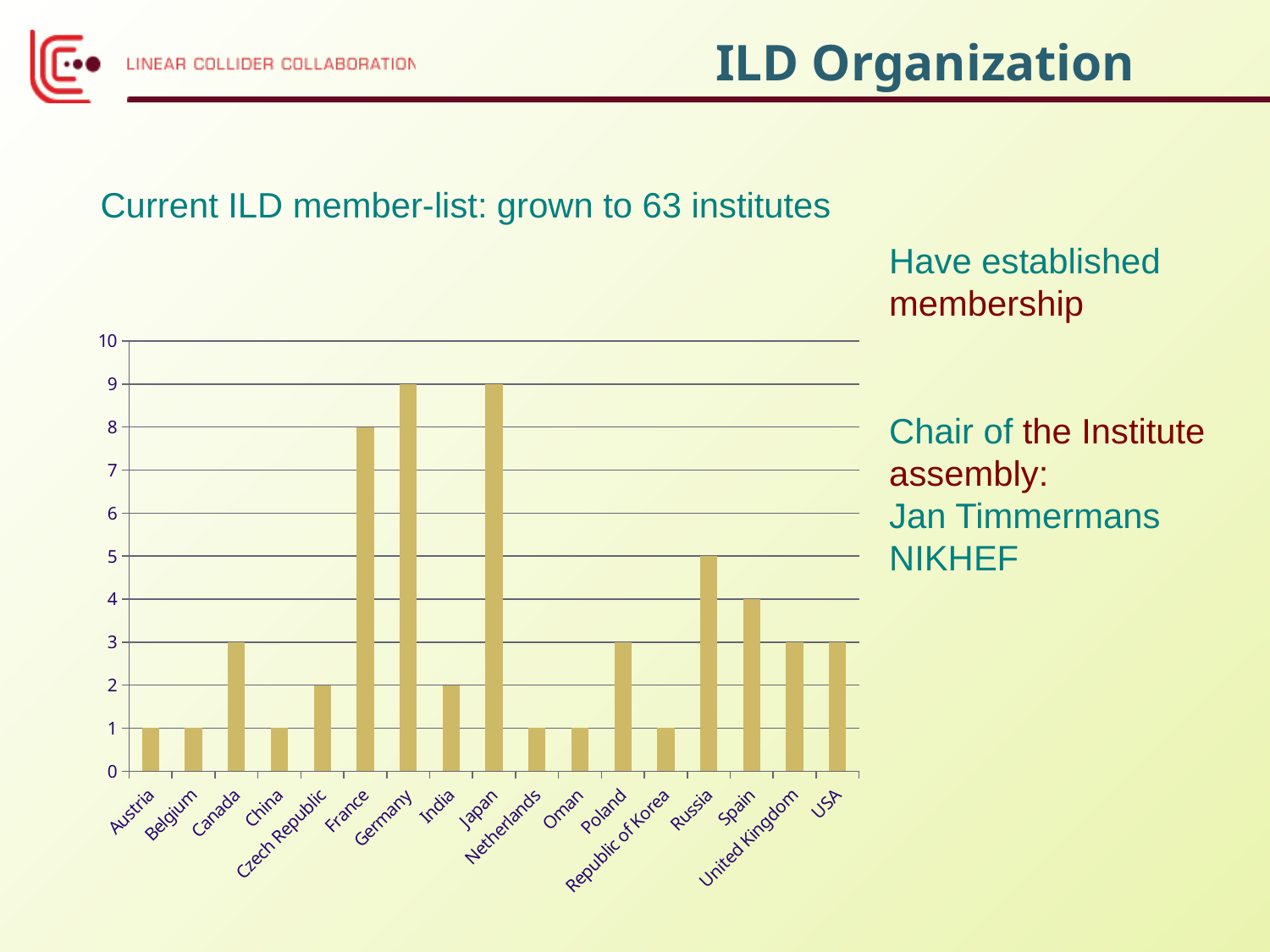
Is the value for Japan greater or less than 5? greater What is the difference between the values for France and Russia? 3 Which is larger, the value for France or the value for Russia? France What is the difference between the values for Germany and France? 1 What is the value for Spain? 4 What kind of chart is shown on the slide? bar chart Which is larger, the value for Spain or the value for Canada? Spain What is the value for Russia? 5 What is the value for Czech Republic? 2 What is the value for Germany? 9 What is the value for France? 8 How many countries are shown on the x axis of the chart? 17